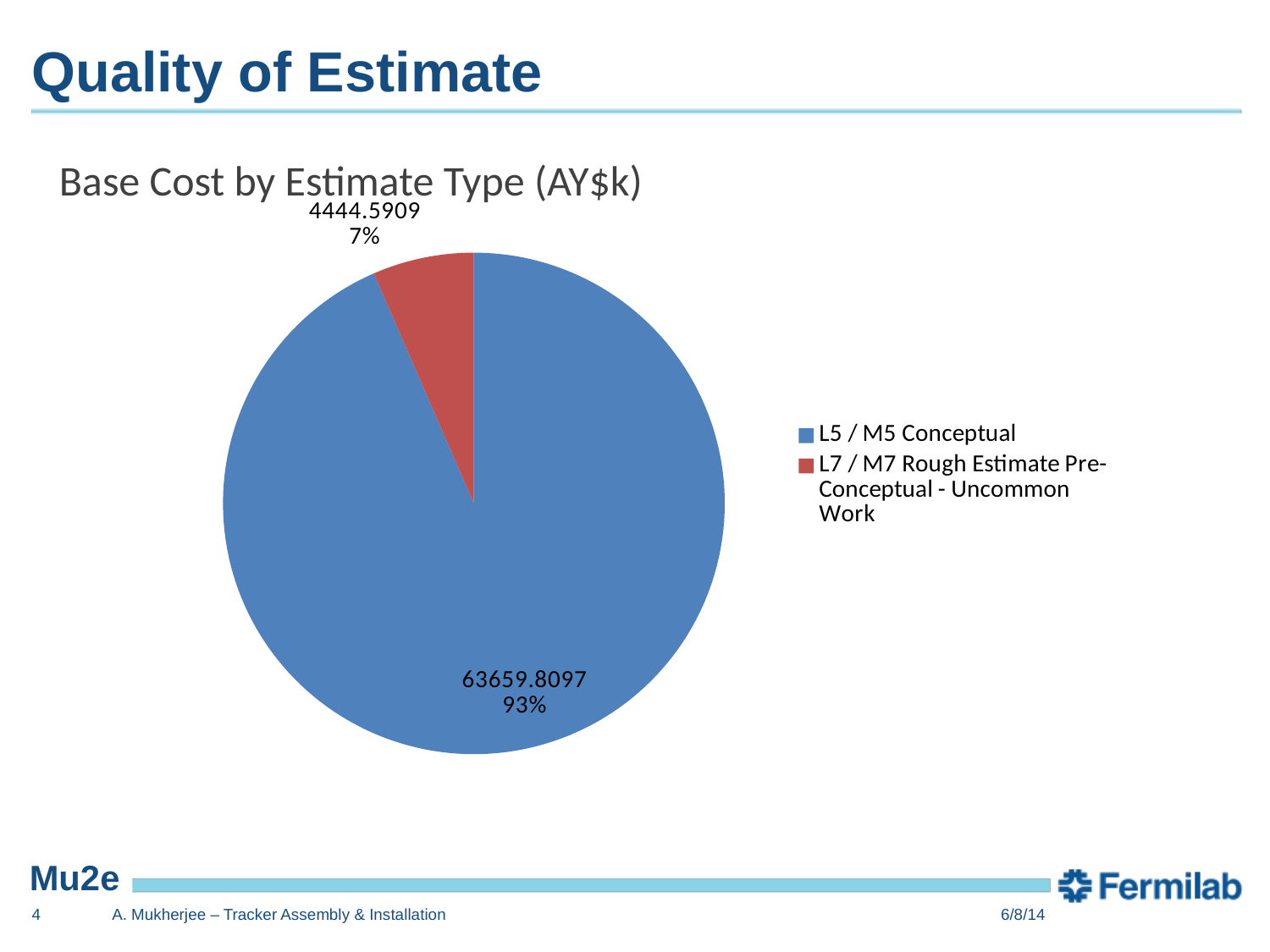
What is the title of the chart? Base Cost by Estimate Type (AY$k) What share of the pie does L5 / M5 Conceptual represent? 93% What kind of chart is shown on the slide? pie chart What is the base cost value for L5 / M5 Conceptual? 63659.8097 Which estimate type has the largest base cost? L5 / M5 Conceptual What colour is the slice for L7 / M7 Rough Estimate Pre-Conceptual - Uncommon Work? red Which is larger, the base cost for L5 / M5 Conceptual or for L7 / M7 Rough Estimate Pre-Conceptual - Uncommon Work? L5 / M5 Conceptual What share of the pie does L7 / M7 Rough Estimate Pre-Conceptual - Uncommon Work represent? 7% Which estimate type has the smallest base cost? L7 / M7 Rough Estimate Pre-Conceptual - Uncommon Work What is the difference between the base cost for L5 / M5 Conceptual and for L7 / M7 Rough Estimate Pre-Conceptual - Uncommon Work? 59215.2188 How many slices does the pie chart have? 2 What is the base cost value for L7 / M7 Rough Estimate Pre-Conceptual - Uncommon Work? 4444.5909